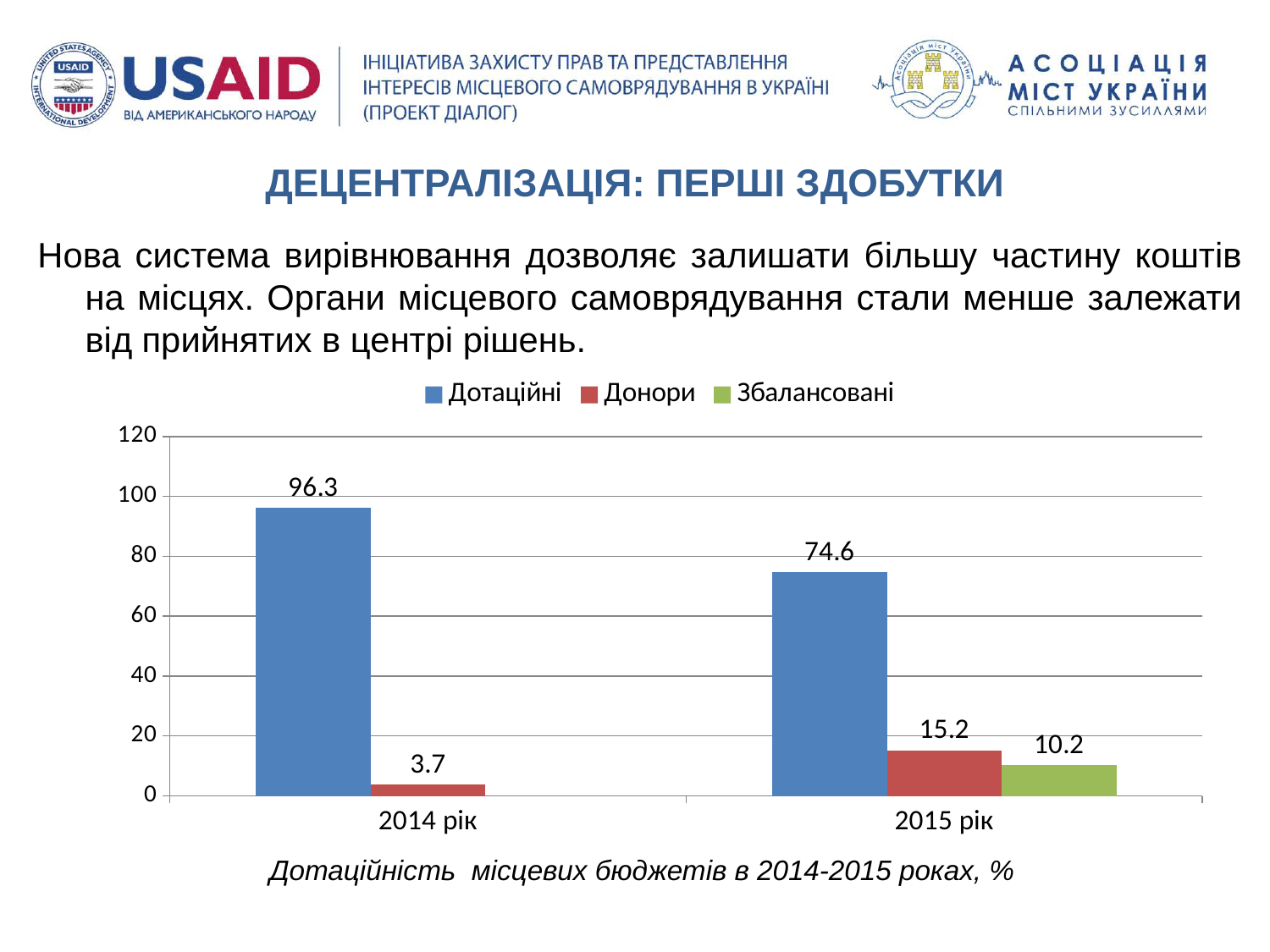
What is the difference between Донори and Збалансовані in 2015 рік? 5 By how much did the value for Дотаційні fall from 2014 рік to 2015 рік? 21.7 How many series does the legend list? 3 What is the value for Донори in 2014 рік? 3.7 What is the value for Донори in 2015 рік? 15.2 Which series has the highest value in 2015 рік? Дотаційні Which is larger: Донори in 2014 рік or Донори in 2015 рік? Донори in 2015 рік What is the value for Збалансовані in 2015 рік? 10.2 What is the value for Дотаційні in 2014 рік? 96.3 Does the value for Дотаційні rise or fall from 2014 рік to 2015 рік? Fall What kind of chart is shown on the slide? Bar chart Which series has the lowest value in 2015 рік? Збалансовані